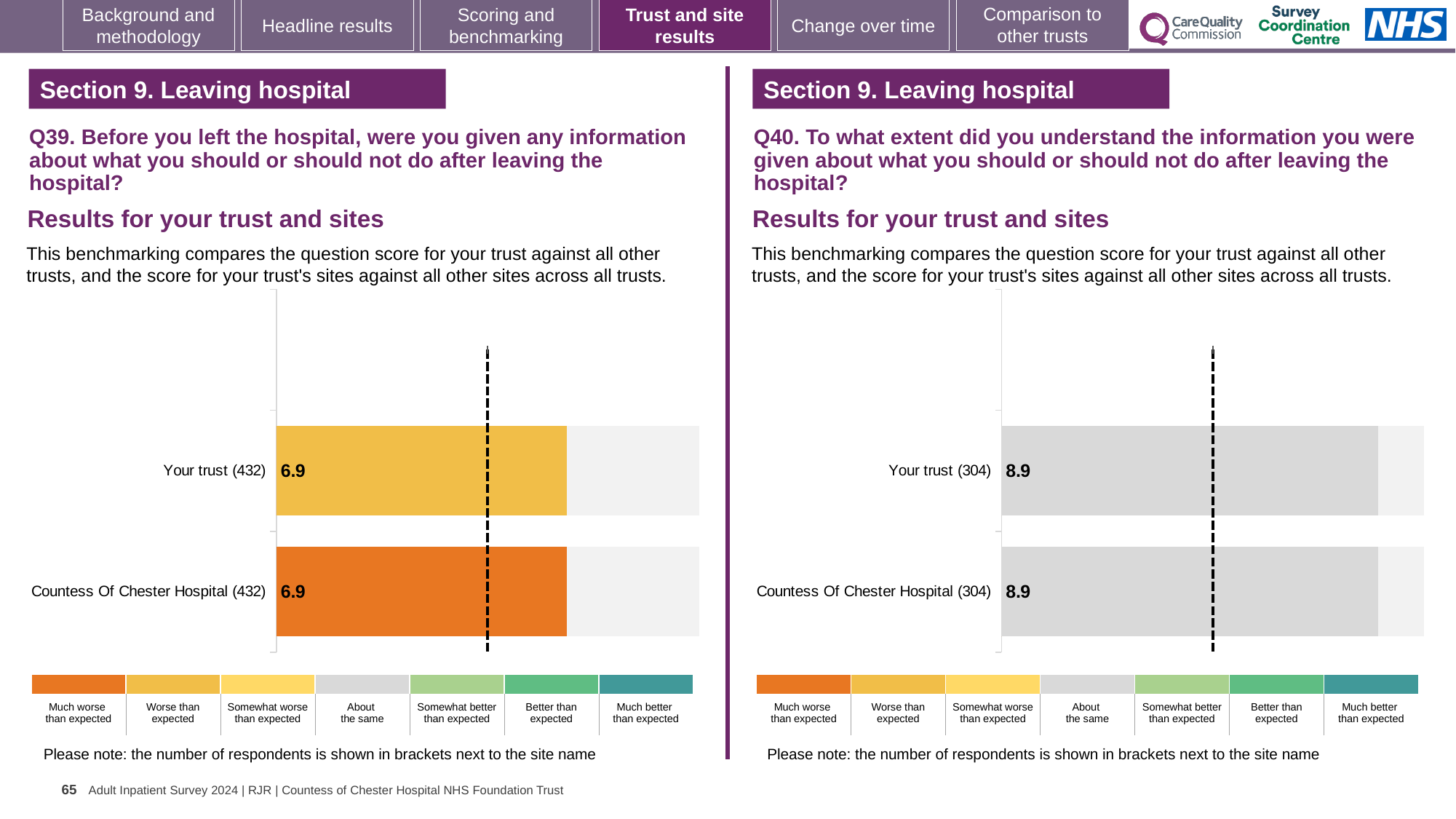
On the Q40 chart (right), what is the difference between the score for Your trust and the score for Countess Of Chester Hospital? 0.0 On the Q39 chart (left), what is the score for Countess Of Chester Hospital (432)? 6.9 On the Q39 chart (left), which benchmark category does the colour of the Countess Of Chester Hospital bar correspond to in the key? Much worse than expected How many bars are plotted on the Q39 chart (left)? 2 On the Q40 chart (right), what is the score for Countess Of Chester Hospital (304)? 8.9 How many respondents are shown in brackets for Your trust on the Q40 chart (right)? 304 What type of chart is used on the Q39 chart (left)? Bar chart On the Q40 chart (right), what is the score for Your trust (304)? 8.9 On the Q40 chart (right), which benchmark category does the grey colour of the bars correspond to in the key? About the same On the Q39 chart (left), what is the difference between the score for Your trust and the score for Countess Of Chester Hospital? 0.0 How many bars are plotted on the Q40 chart (right)? 2 On the Q39 chart (left), what is the score for Your trust (432)? 6.9